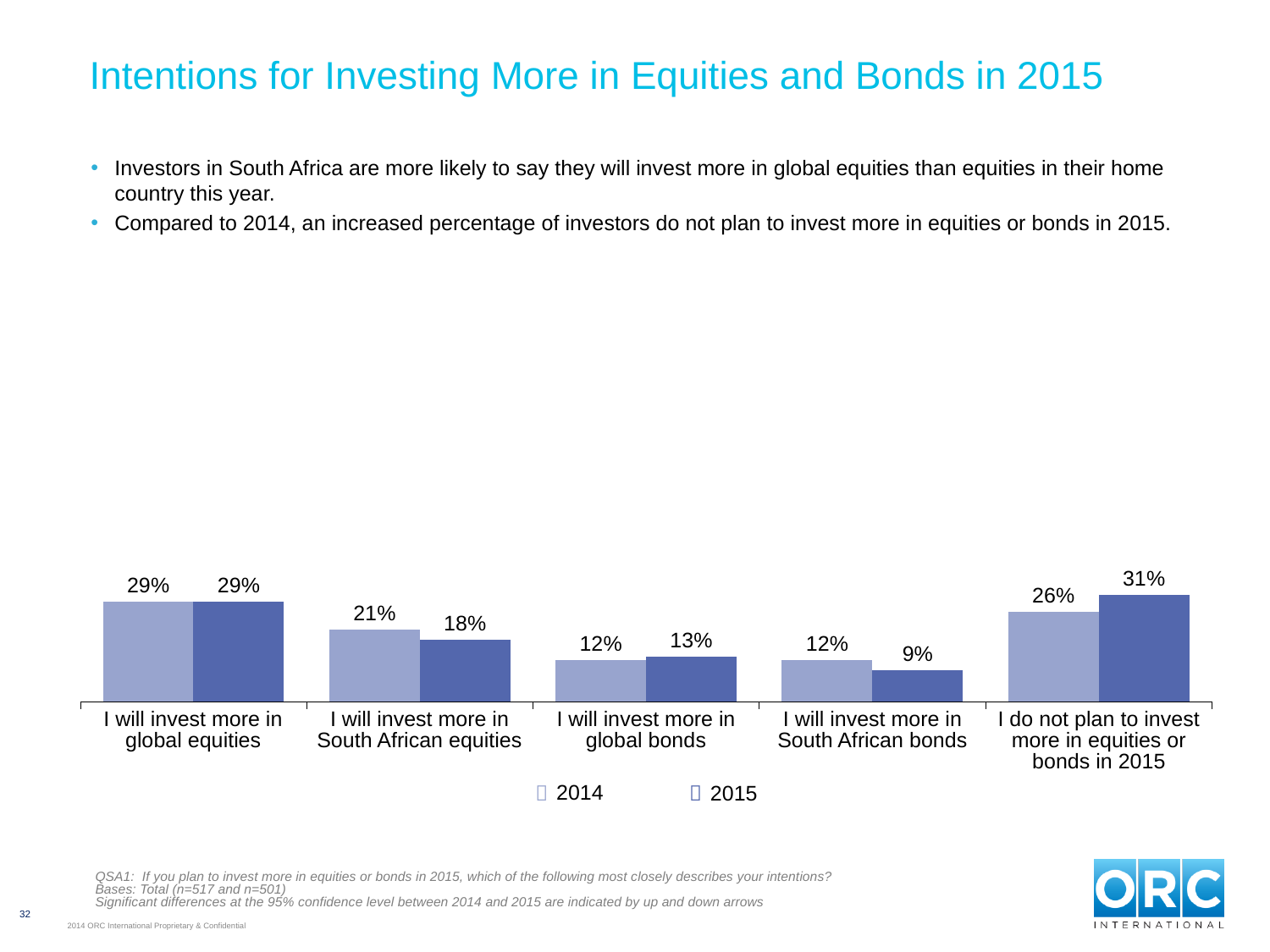
What percentage of investors said they will invest more in South African equities in 2014? 21% Which category has the lowest value in the 2015 series? I will invest more in South African bonds What are the two series listed in the chart's legend? 2014 and 2015 What percentage of investors said they do not plan to invest more in equities or bonds in 2015, according to the 2015 series? 31% What is the difference between the 2014 and 2015 values for 'I do not plan to invest more in equities or bonds in 2015'? 5 percentage points How many categories are shown on the x axis of the chart? 5 What percentage of investors said they will invest more in South African bonds in 2015? 9% Which category has the highest value in the 2015 series? I do not plan to invest more in equities or bonds in 2015 Which is larger: the 2014 value for 'I will invest more in South African equities' or the 2015 value for the same category? 2014 What kind of chart is shown on the slide? Bar chart How many series does the chart's legend list? 2 What percentage of investors said they will invest more in global equities in 2015? 29%